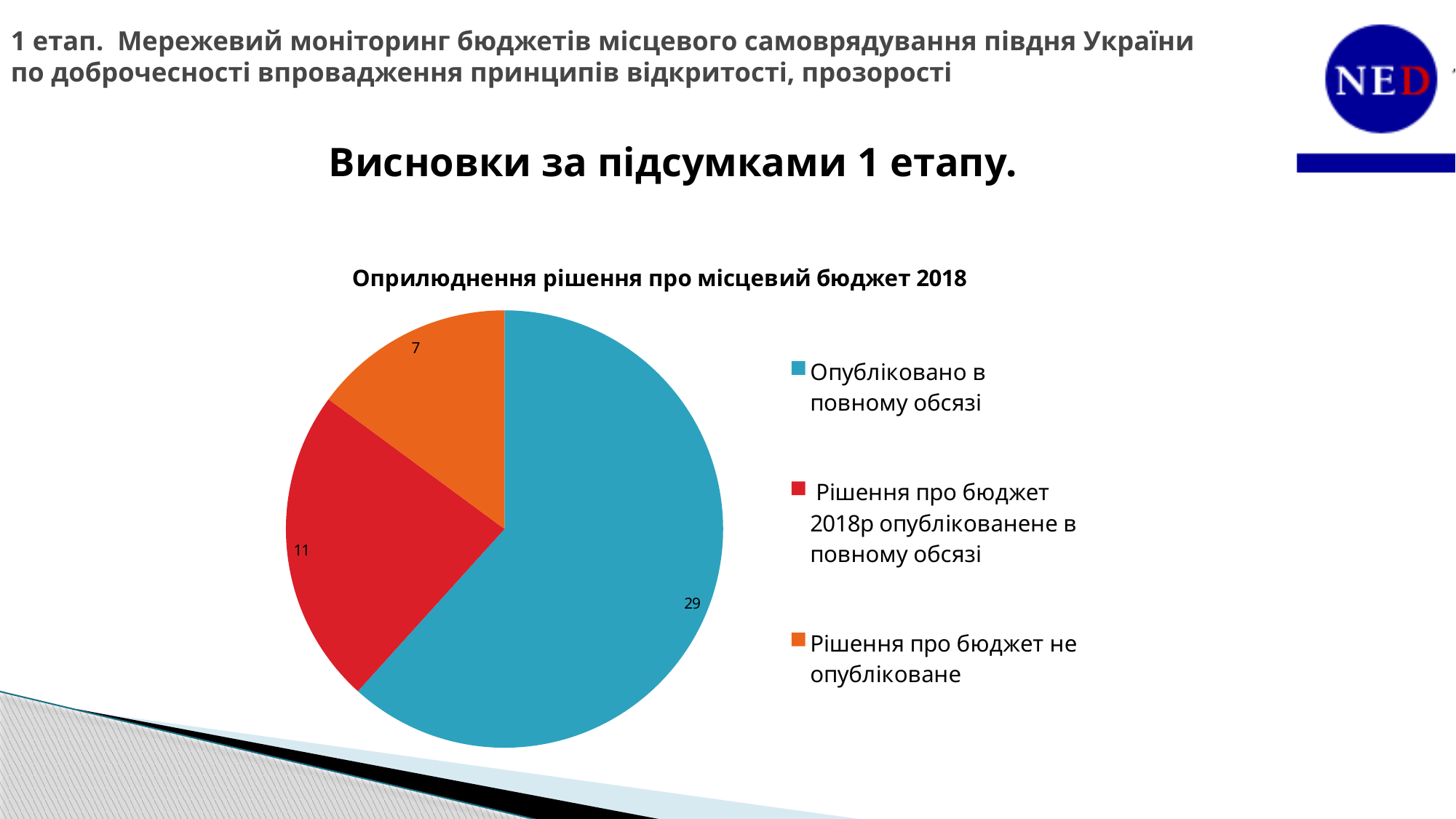
What is the value for "Рішення про бюджет 2018р опублікованене в повному обсязі"? 11 Which category has the largest slice? Опубліковано в повному обсязі What is the value for "Рішення про бюджет не опубліковане"? 7 What colour is the slice for "Рішення про бюджет не опубліковане"? orange What is the value for "Опубліковано в повному обсязі"? 29 What is the difference between the value for "Опубліковано в повному обсязі" and the value for "Рішення про бюджет не опубліковане"? 22 Which is larger: the value for "Рішення про бюджет 2018р опублікованене в повному обсязі" or the value for "Рішення про бюджет не опубліковане"? Рішення про бюджет 2018р опублікованене в повному обсязі Which category has the smallest slice? Рішення про бюджет не опубліковане What type of chart is shown on the slide? pie chart What is the title of the chart? Оприлюднення рішення про місцевий бюджет 2018 How many slices does the pie chart have? 3 How many entries does the legend list? 3